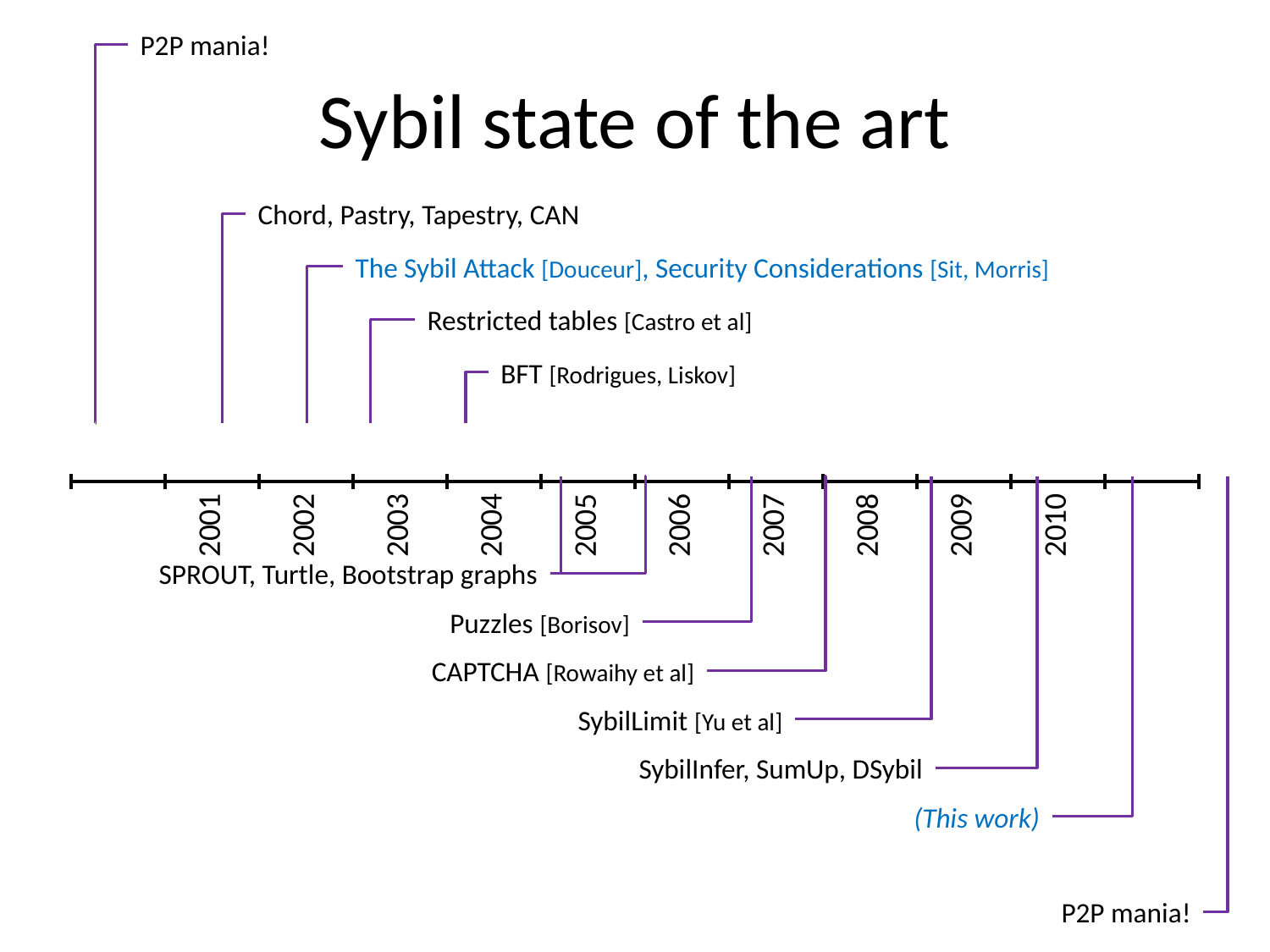
Is the event "Chord, Pastry, Tapestry, CAN" placed before or after the 2002 tick on the timeline? before Which event on the timeline is placed earlier, Restricted tables [Castro et al] or BFT [Rodrigues, Liskov]? Restricted tables [Castro et al] What is the earliest year labelled on the timeline? 2001 What is the title of the slide? Sybil state of the art Is the event "(This work)" placed before or after the 2010 tick on the timeline? after What kind of chart is shown on the slide? timeline Which event label appears immediately before "(This work)" on the timeline? SybilInfer, SumUp, DSybil How many year labels are shown along the timeline axis? 10 Which label appears at both the far left and the far right ends of the timeline? P2P mania! What is the latest year labelled on the timeline? 2010